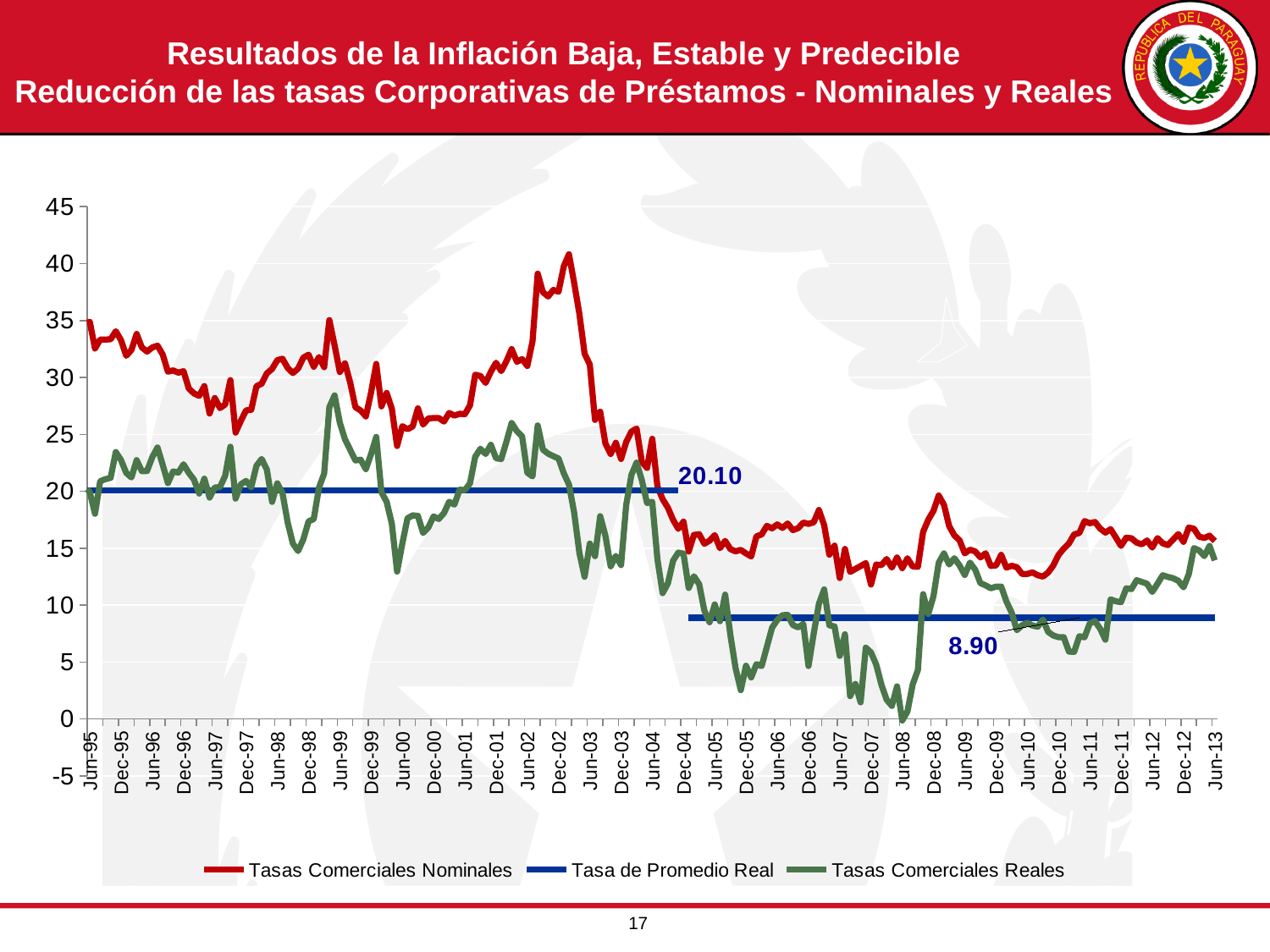
Is the Tasas Comerciales Nominales value at Jun-13 greater or less than 20? less Which series reaches the highest value on the chart? Tasas Comerciales Nominales What kind of chart is shown on the slide? line chart How many series does the legend list? 3 Is the labelled average real rate for the earlier period higher or lower than for the later period? higher What is the difference between the two labelled Tasa de Promedio Real values, 20.10 and 8.90? 11.20 Overall, do the Tasas Comerciales Nominales rise or fall from Jun-95 to Jun-13? fall What value is labelled on the Tasa de Promedio Real line for the later period (around Dec-04 to Jun-13)? 8.90 Is the Tasas Comerciales Reales value around Jun-08 greater or less than 5? less What colour is the Tasas Comerciales Reales line? green Is the Tasas Comerciales Nominales value at Jun-95 greater or less than 30? greater What value is labelled on the Tasa de Promedio Real line for the earlier period (Jun-95 to around Dec-04)? 20.10